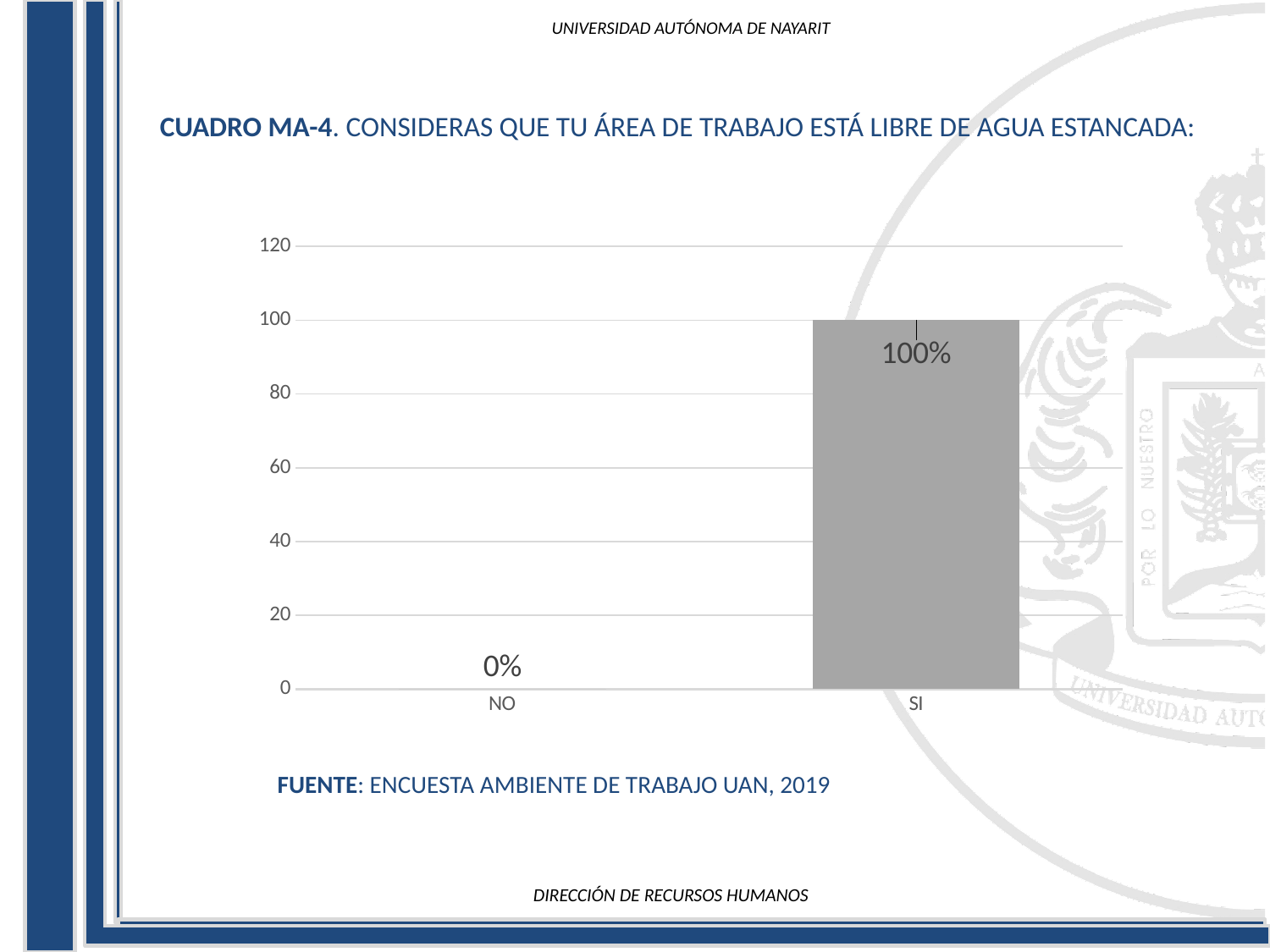
What is the value for SI? 100% Which is larger, the value for NO or the value for SI? SI Which category has the lowest value? NO What source is cited below the chart? ENCUESTA AMBIENTE DE TRABAJO UAN, 2019 What is the value for NO? 0% Which category has the highest value? SI What is the highest tick value shown on the vertical axis? 120 What kind of chart is shown on the slide? bar chart Is the value for SI greater or less than 80? greater How many categories are shown on the x axis? 2 What is the difference between the values for SI and NO? 100%